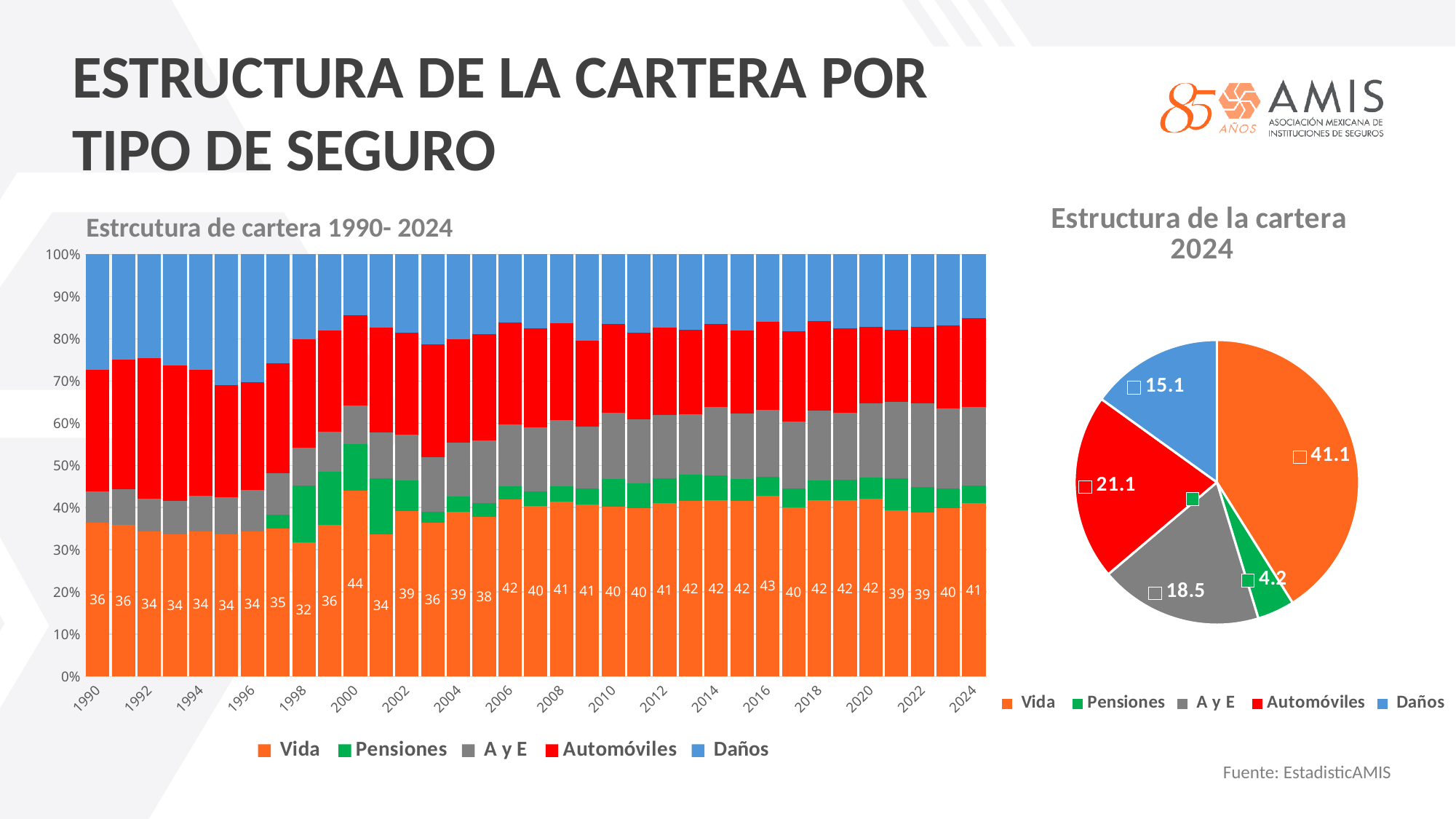
In the 'Estrcutura de cartera 1990- 2024' chart, what is the difference between the Vida values for 2000 and 1998? 12 In the 'Estrcutura de cartera 1990- 2024' chart, which year has the highest labelled Vida value? 2000 In the 'Estructura de la cartera 2024' pie chart, what is the value shown for Automóviles? 21.1 In the 'Estructura de la cartera 2024' pie chart, what is the difference between the A y E value and the Daños value? 3.4 In the 'Estrcutura de cartera 1990- 2024' chart, which year has the lowest labelled Vida value? 1998 In the 'Estrcutura de cartera 1990- 2024' chart, what is the Vida value labelled for 2000? 44 In the 'Estructura de la cartera 2024' pie chart, what is the value shown for Vida? 41.1 What kind of chart is the 'Estrcutura de cartera 1990- 2024' chart? Stacked bar chart In the 'Estrcutura de cartera 1990- 2024' chart, what is the Vida value labelled for 1998? 32 In the 'Estructura de la cartera 2024' pie chart, which category has the smallest slice? Pensiones How many series does the legend of the 'Estrcutura de cartera 1990- 2024' chart list? 5 In the 'Estrcutura de cartera 1990- 2024' chart, which year has a larger Vida value, 2016 or 2024? 2016